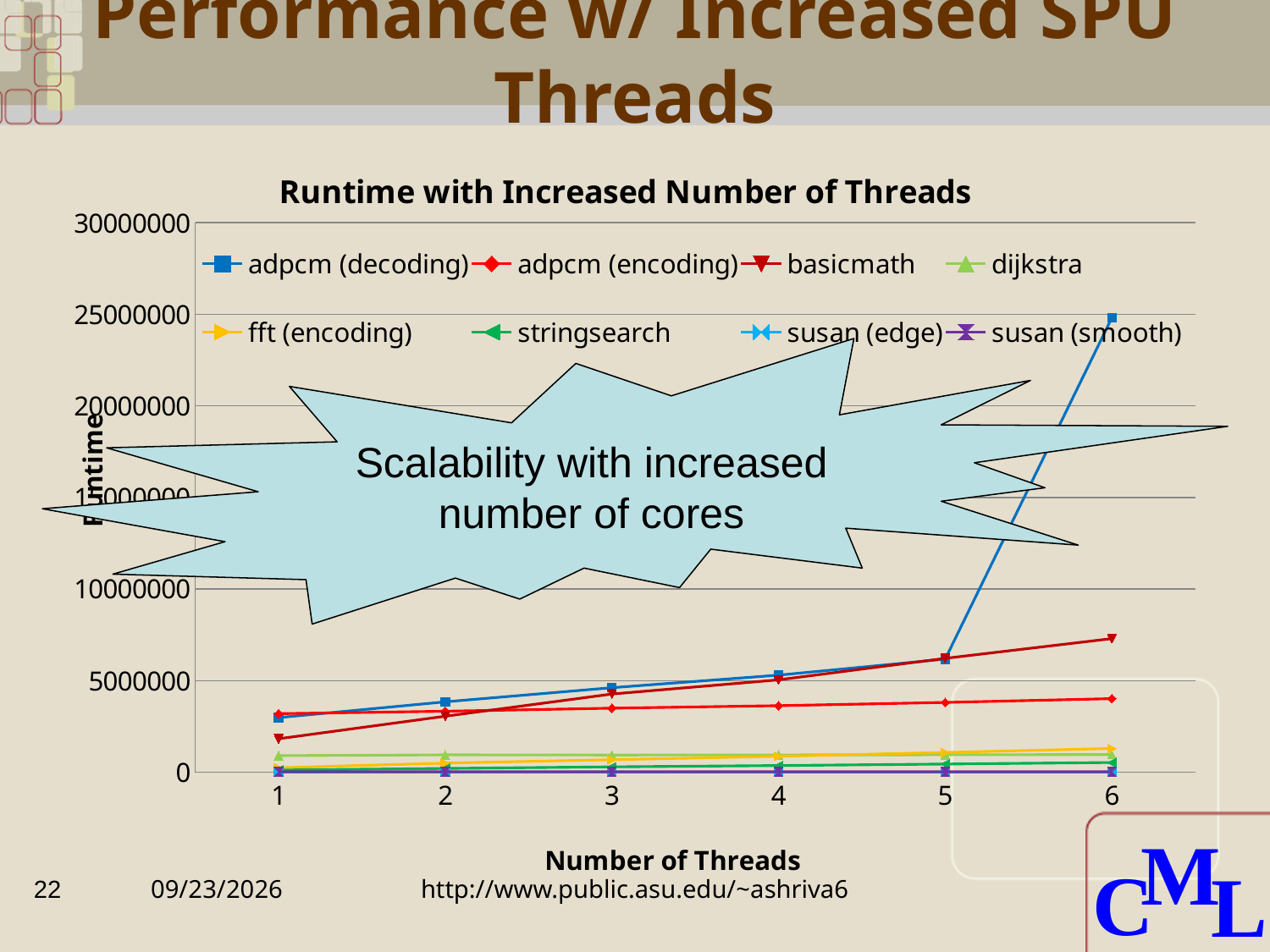
Is the runtime for adpcm (decoding) at 6 threads greater or less than 20000000? greater At 6 threads, which has the larger runtime: basicmath or adpcm (encoding)? basicmath What kind of chart is shown on the slide? line chart Is the runtime for basicmath at 6 threads greater or less than 10000000? less Does the runtime for adpcm (decoding) rise or fall as the number of threads increases? rises Which series has the highest runtime at 6 threads? adpcm (decoding) How many thread counts are plotted along the x axis? 6 What is the label of the x axis? Number of Threads How many series does the legend list? 8 Is the runtime for adpcm (encoding) at 1 thread greater or less than 5000000? less At 1 thread, which has the larger runtime: adpcm (encoding) or basicmath? adpcm (encoding) What is the title of the chart? Runtime with Increased Number of Threads